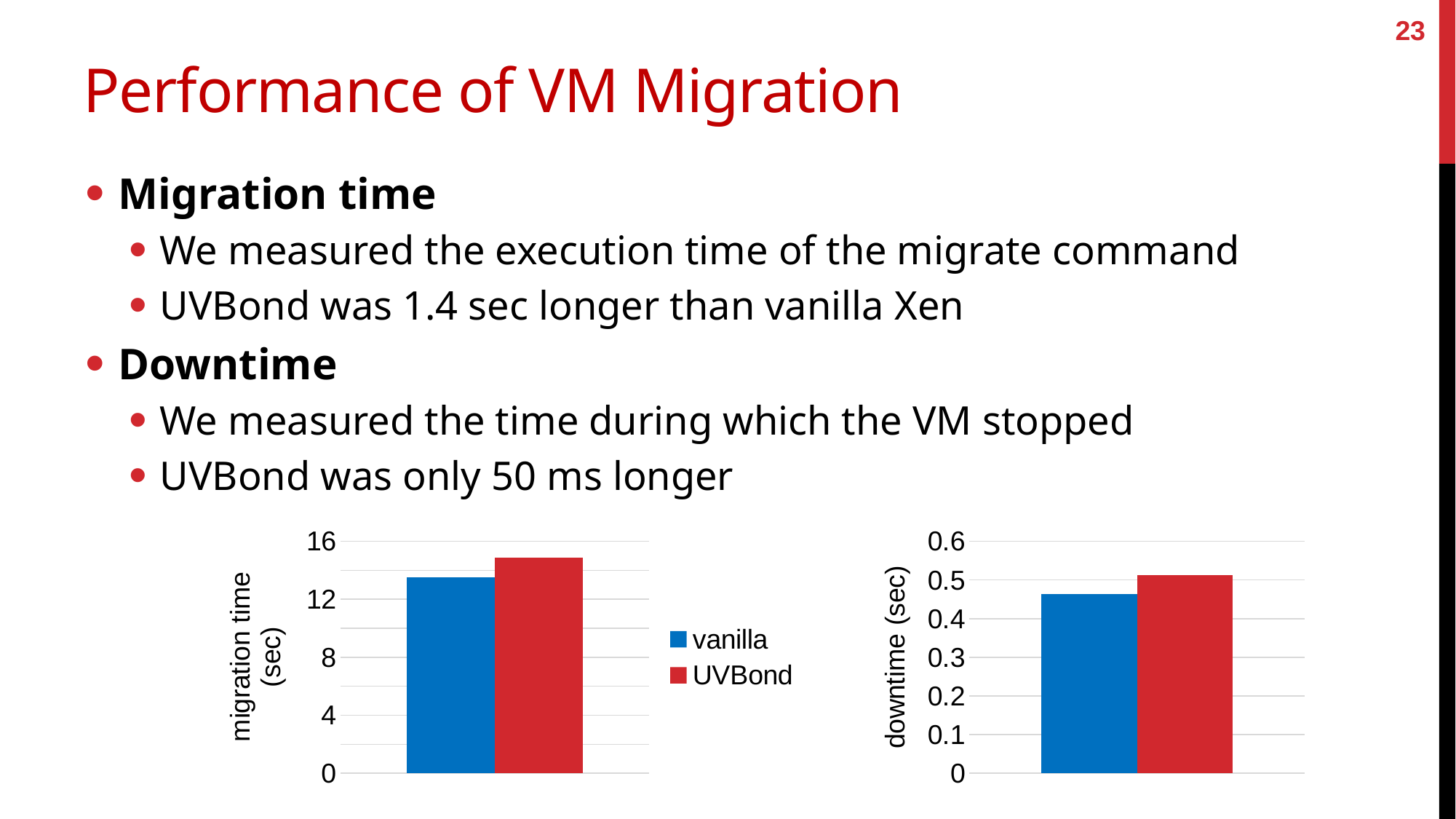
What kind of chart is the left chart (migration time)? bar chart What kind of chart is the right chart (downtime)? bar chart In the right chart (downtime), which is larger, vanilla or UVBond? UVBond Which colour represents UVBond in the legend? red In the right chart (downtime), is the value for vanilla greater or less than 0.5? less In the left chart (migration time), is the value for UVBond greater or less than 16? less What is the y-axis label of the right chart? downtime (sec) In the right chart (downtime), is the value for UVBond greater or less than 0.4? greater In the left chart (migration time), which is larger, vanilla or UVBond? UVBond In the left chart, which series has the lowest migration time? vanilla How many series does the legend list? 2